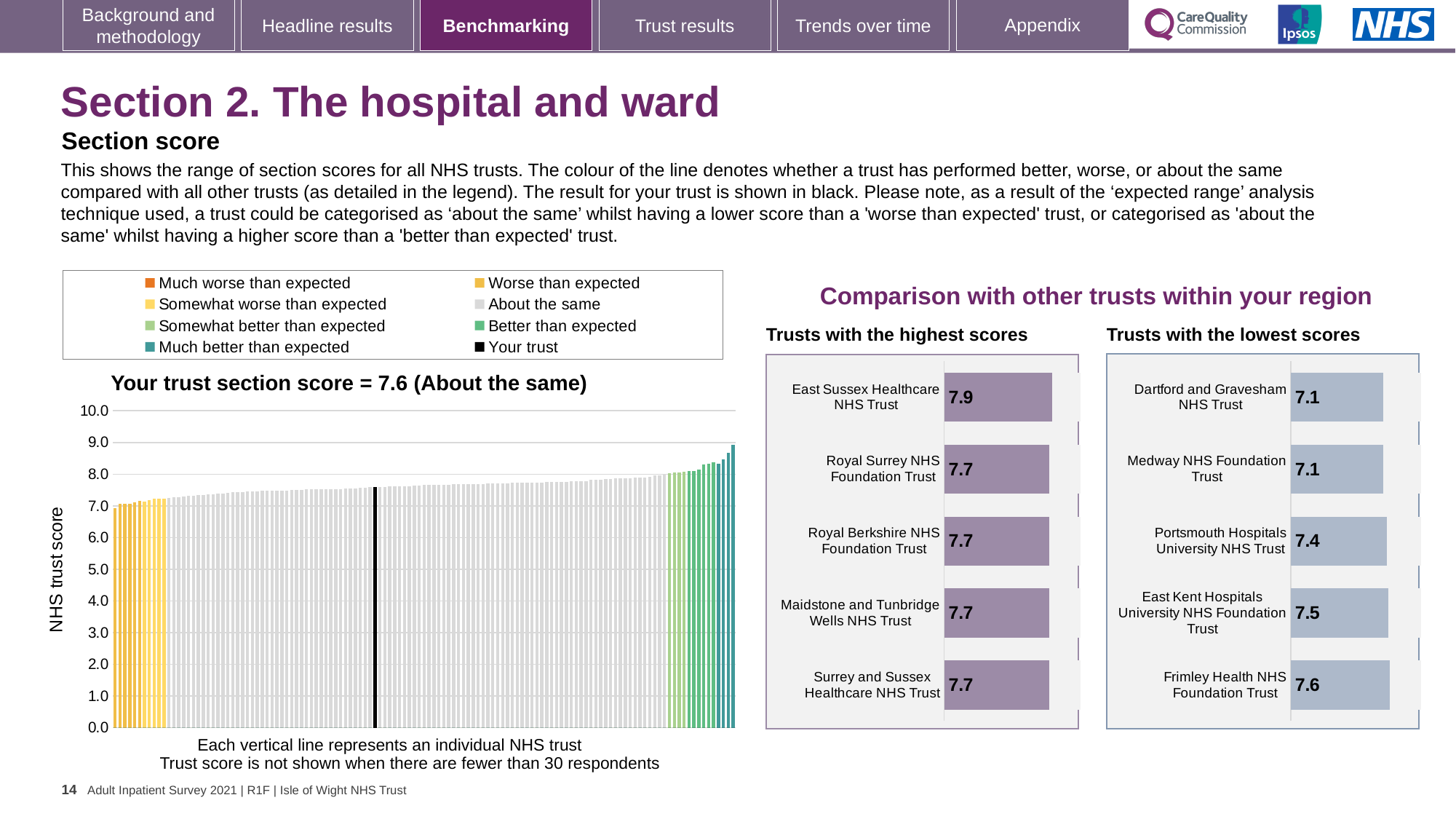
In the 'Your trust section score' chart, what is the section score for your trust? 7.6 In the 'Trusts with the highest scores' chart, which trust has the highest score? East Sussex Healthcare NHS Trust In the 'Your trust section score' chart, what kind of chart is shown? bar chart In the 'Your trust section score' chart, do the trust scores rise or fall from left to right along the x axis? rise In the 'Trusts with the highest scores' chart, what is the score for East Sussex Healthcare NHS Trust? 7.9 In the 'Trusts with the lowest scores' chart, what is the score for Portsmouth Hospitals University NHS Trust? 7.4 In the 'Trusts with the highest scores' chart, what is the difference between the scores of East Sussex Healthcare NHS Trust and Royal Surrey NHS Foundation Trust? 0.2 In the 'Trusts with the highest scores' chart, how many trusts are shown? 5 In the 'Your trust section score' chart, what is the label on the y axis? NHS trust score In the 'Trusts with the lowest scores' chart, which trust has the highest score? Frimley Health NHS Foundation Trust In the 'Trusts with the lowest scores' chart, what is the difference between the scores of Frimley Health NHS Foundation Trust and Dartford and Gravesham NHS Trust? 0.5 How many entries does the legend above the 'Your trust section score' chart list? 8